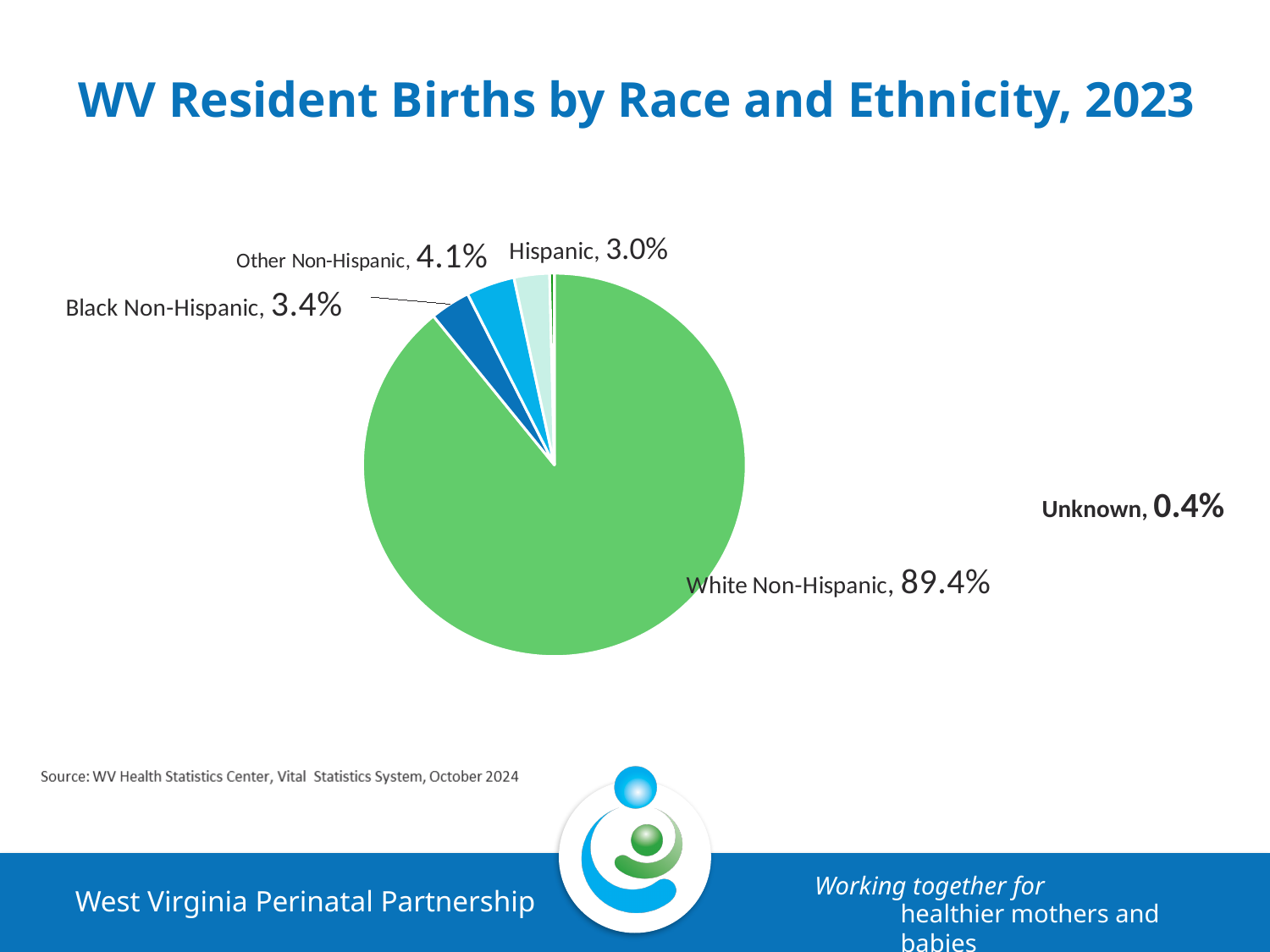
Which category has the largest slice of the pie? White Non-Hispanic What percentage of births is labelled Hispanic on the pie chart? 3.0% What share of WV resident births in 2023 were White Non-Hispanic? 89.4% What type of chart is shown on the slide? Pie chart What is the value shown for Black Non-Hispanic? 3.4% Which category has the smallest slice of the pie? Unknown Which is larger, the Other Non-Hispanic share or the Black Non-Hispanic share? Other Non-Hispanic What percentage of births is labelled Unknown? 0.4% How many categories are shown in the pie chart? 5 What is the difference in percentage points between the Other Non-Hispanic and Hispanic shares? 1.1 percentage points What is the title of the chart? WV Resident Births by Race and Ethnicity, 2023 What is the value shown for Other Non-Hispanic? 4.1%